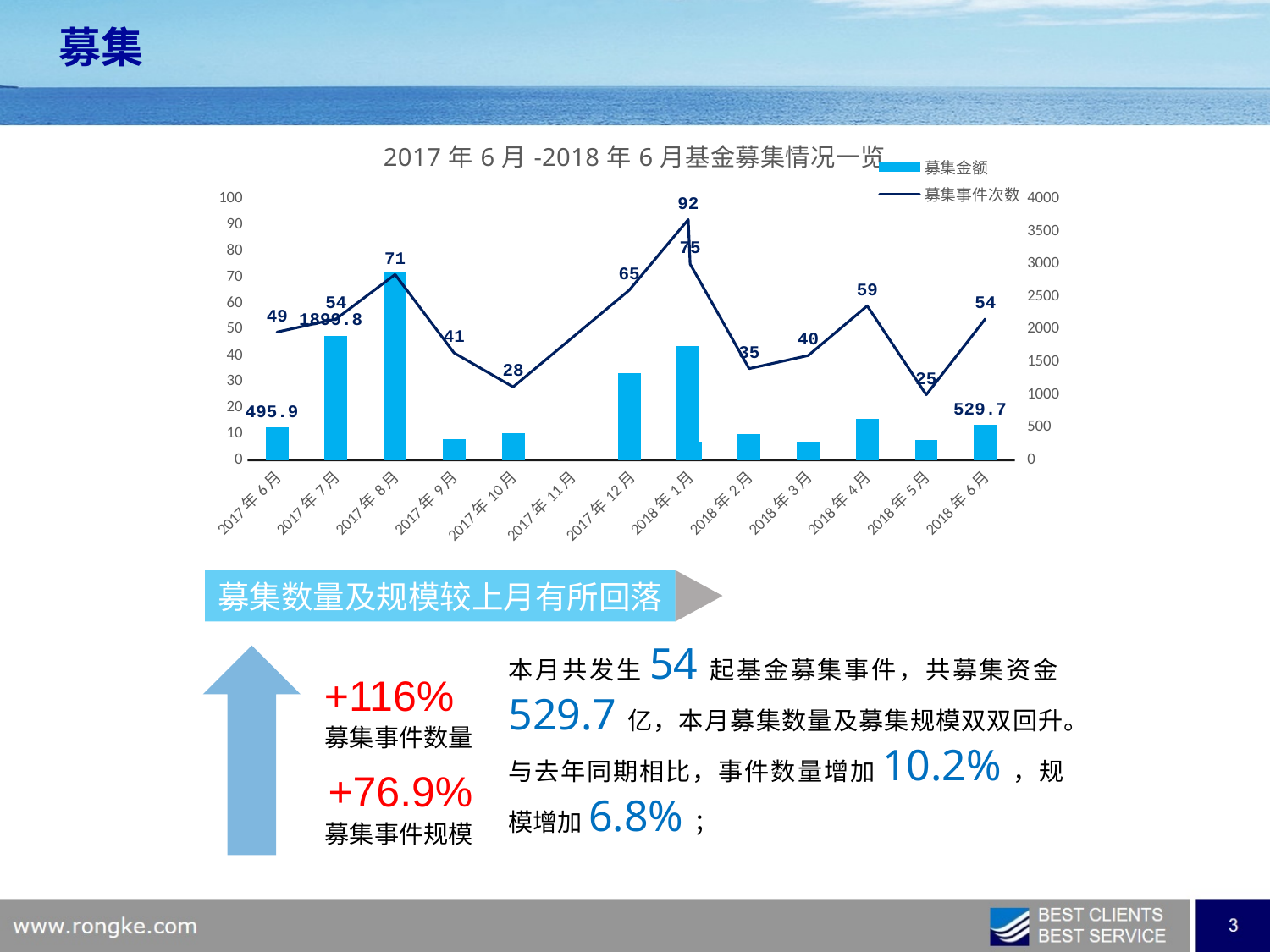
What is the 募集金额 value for 2018年6月? 529.7 Which month has the tallest 募集金额 bar? 2017年8月 How many series does the chart legend list? 2 What is the title of the chart? 2017年6月-2018年6月基金募集情况一览 How many months are shown on the x axis of the chart? 13 What is the difference between the 募集金额 values for 2018年6月 and 2017年6月? 33.8 Which is larger, the 募集事件次数 value for 2017年8月 or for 2018年4月? 2017年8月 What kind of chart is shown on the slide? A combined bar and line chart Which month has the lowest 募集事件次数 value? 2018年5月 Is the 募集金额 bar for 2017年8月 greater or less than 2500? greater What is the 募集金额 value for 2017年7月? 1899.8 What is the 募集事件次数 value for 2017年6月? 49